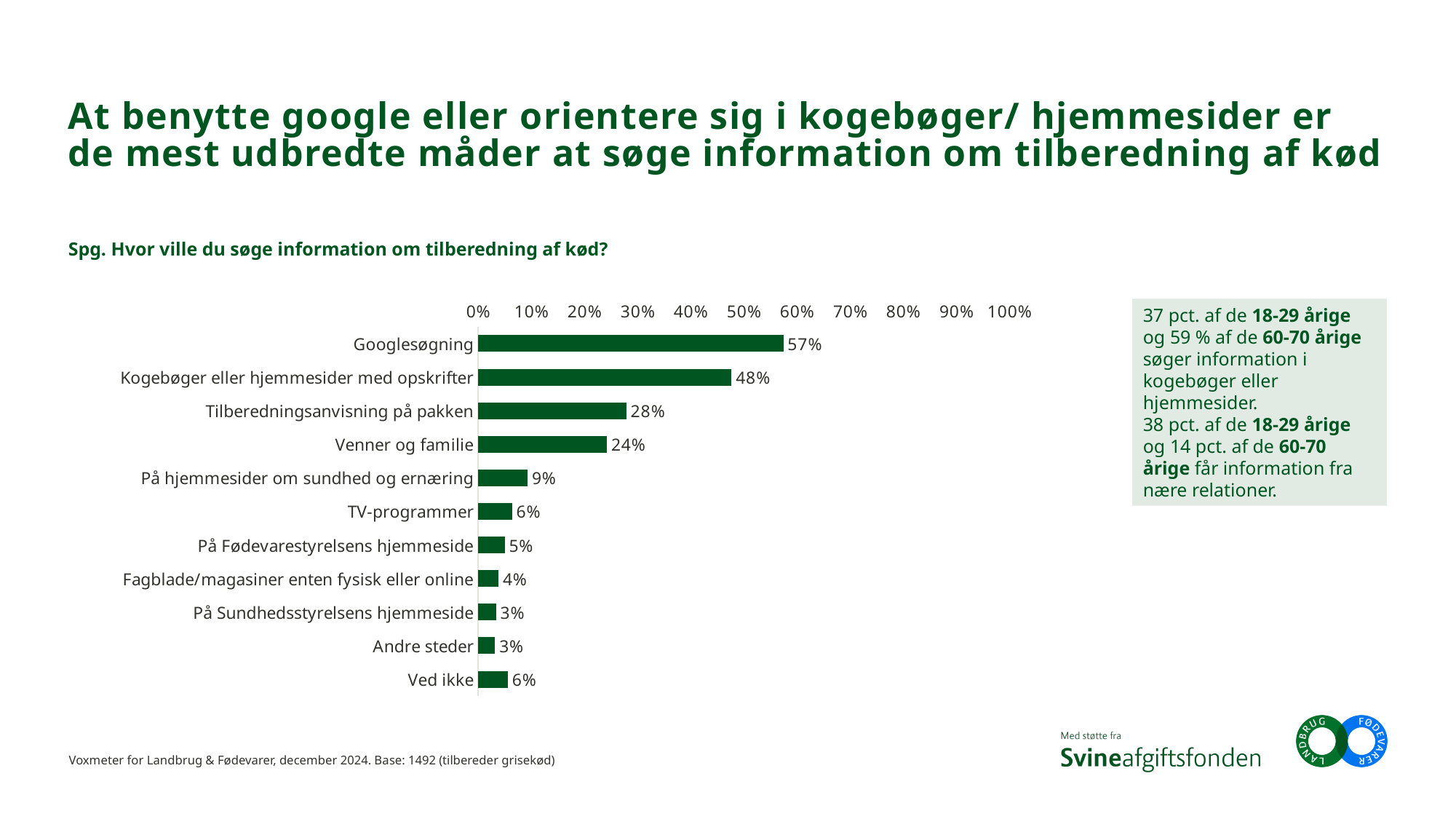
What is the difference between the values for Tilberedningsanvisning på pakken and Venner og familie? 4 percentage points Is the value for Kogebøger eller hjemmesider med opskrifter greater or less than 50%? less Which category has the highest value in the chart? Googlesøgning How many categories are shown in the bar chart? 11 What is the value shown for På Fødevarestyrelsens hjemmeside? 5% What is the highest value labelled on the percentage axis of the chart? 100% What is the value shown for Ved ikke? 6% What type of chart is shown on the slide? Bar chart What is the difference between the values for Googlesøgning and Kogebøger eller hjemmesider med opskrifter? 9 percentage points What percentage of respondents would search for information about meat preparation via Googlesøgning? 57% Which is larger: the value for TV-programmer or the value for Fagblade/magasiner enten fysisk eller online? TV-programmer What is the value shown for Venner og familie? 24%